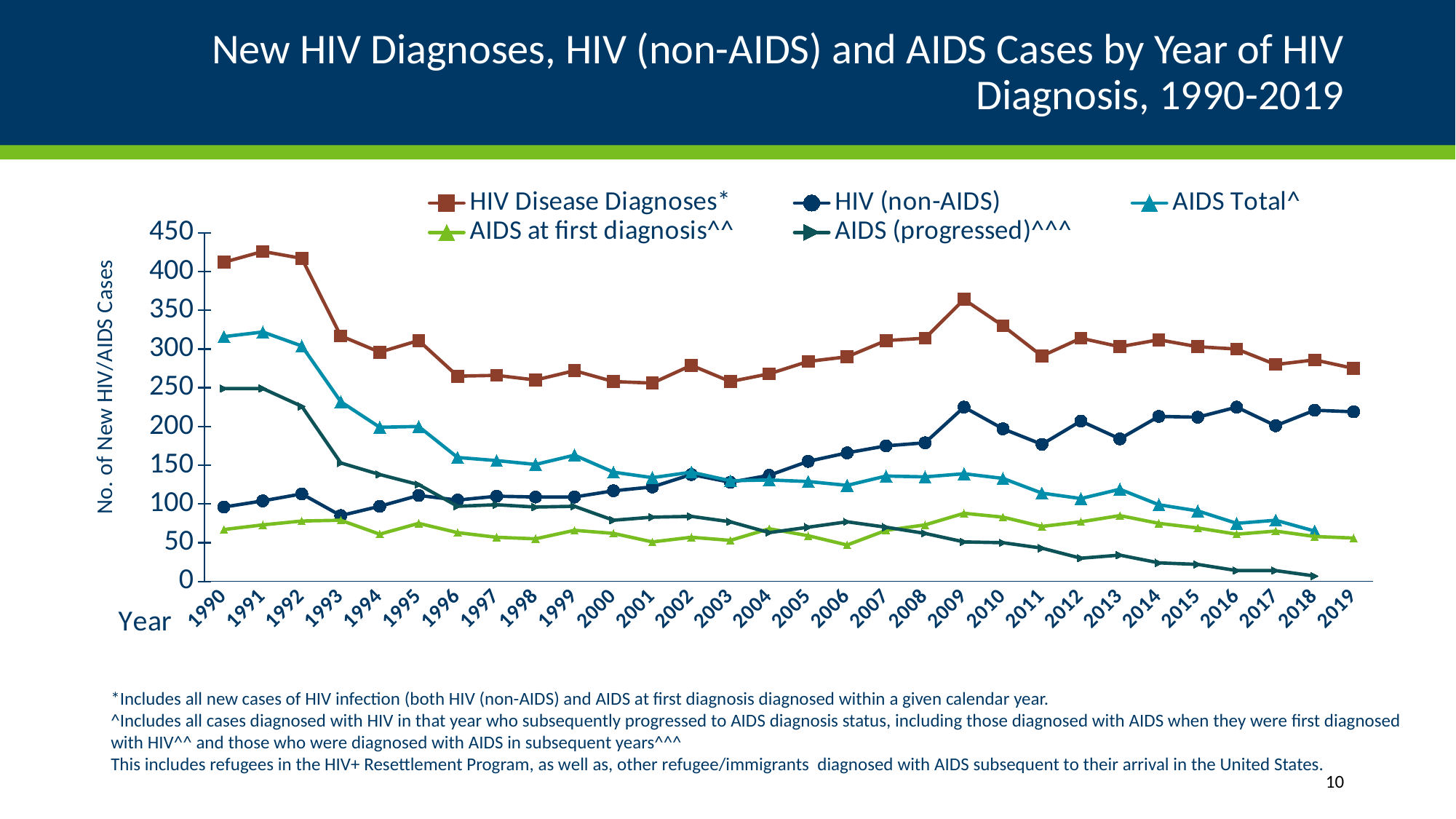
What kind of chart is shown on the slide? line chart How many series does the legend list? 5 What is the label on the y axis? No. of New HIV/AIDS Cases Is the value for HIV (non-AIDS) in 1990 greater or less than 150? less In which year is the AIDS (progressed)^^^ series at its lowest? 2018 Is the value for AIDS Total^ in 1990 greater or less than 300? greater Is the value for HIV Disease Diagnoses* in 2009 greater or less than 350? greater Does the AIDS (progressed)^^^ series rise or fall overall from 1990 to 2018? fall In 1990, which is larger: AIDS Total^ or HIV (non-AIDS)? AIDS Total^ How many years are plotted along the x axis? 30